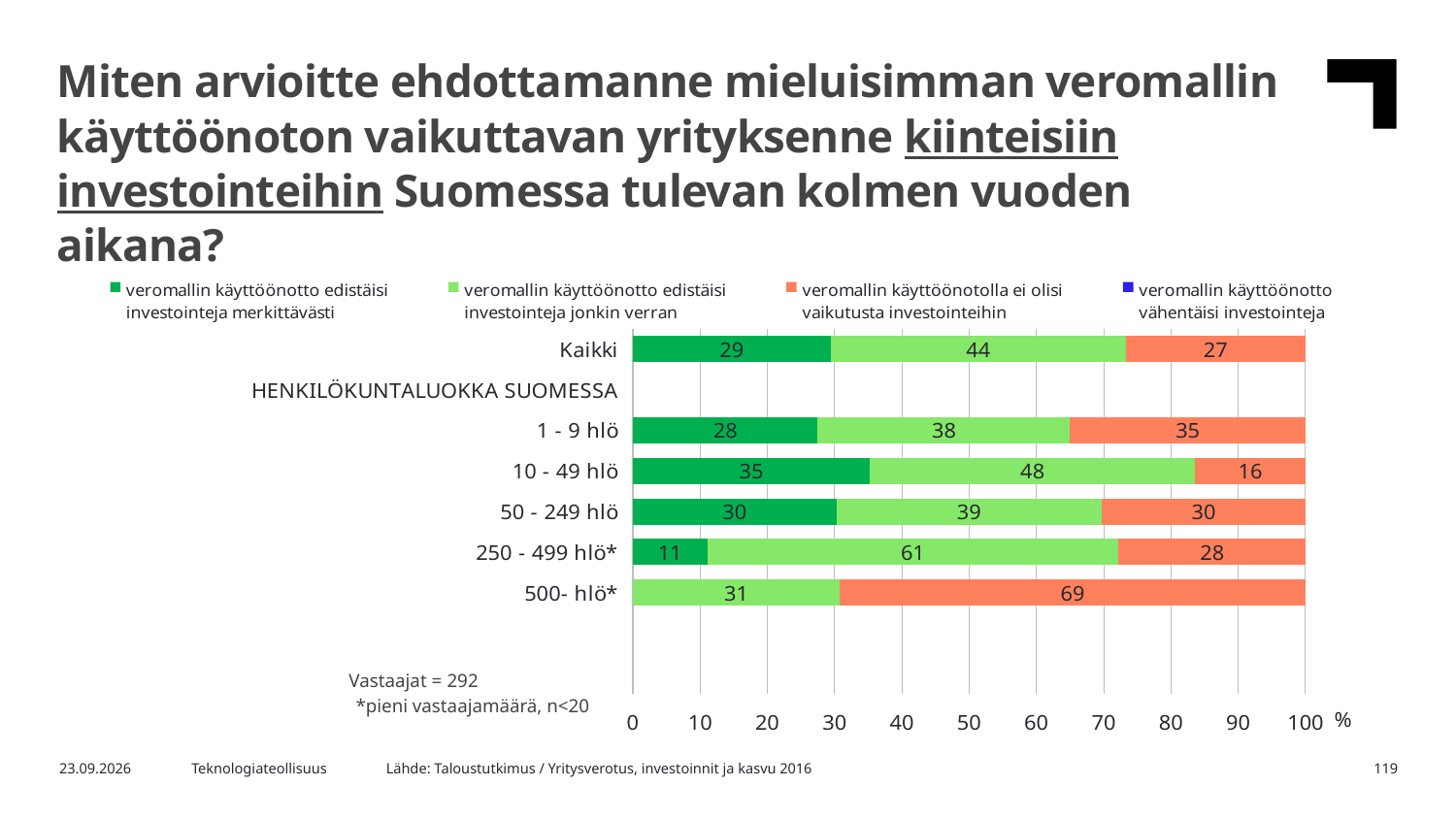
How many series does the legend list? 4 What is the value for 'veromallin käyttöönotolla ei olisi vaikutusta investointeihin' in the 500- hlö* bar? 69 Which category has the highest value for 'veromallin käyttöönotto edistäisi investointeja merkittävästi'? 10 - 49 hlö What is the value for 'veromallin käyttöönotto edistäisi investointeja merkittävästi' in the Kaikki bar? 29 What is the value for 'veromallin käyttöönotto edistäisi investointeja jonkin verran' in the 250 - 499 hlö* bar? 61 Which category has the lowest value for 'veromallin käyttöönotolla ei olisi vaikutusta investointeihin'? 10 - 49 hlö How many respondents (Vastaajat) are stated on the slide? 292 What kind of chart is shown on the slide? stacked bar chart Which is larger: the 'veromallin käyttöönotto edistäisi investointeja jonkin verran' value for Kaikki or for 50 - 249 hlö? Kaikki What is the value for 'veromallin käyttöönotto edistäisi investointeja merkittävästi' in the 10 - 49 hlö bar? 35 What is the total of the 250 - 499 hlö* stacked bar? 100 What is the difference between the 'veromallin käyttöönotolla ei olisi vaikutusta investointeihin' values for 1 - 9 hlö and 10 - 49 hlö? 19